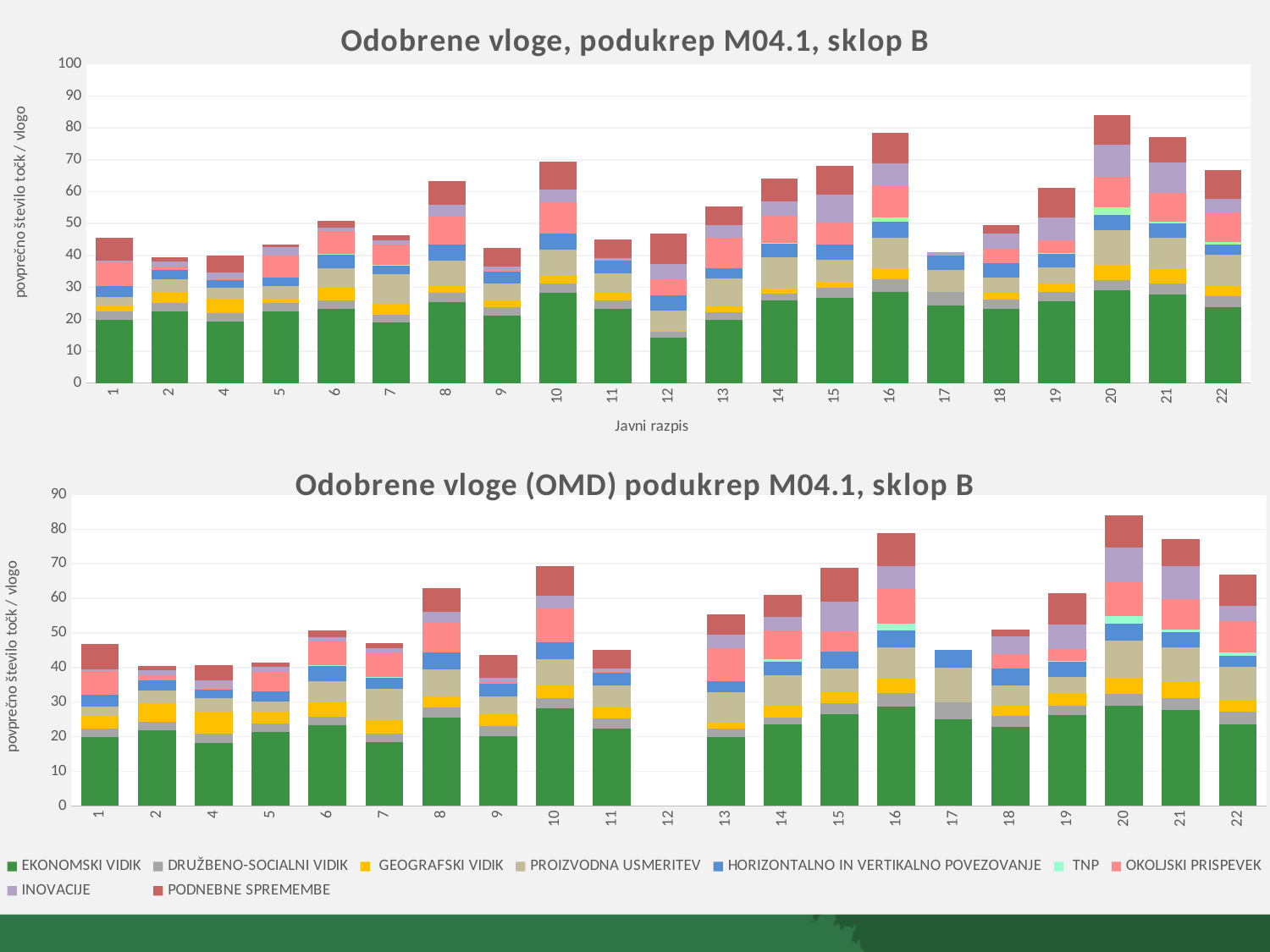
What kind of chart is the top chart, 'Odobrene vloge, podukrep M04.1, sklop B'? Stacked bar chart In the top chart, which category has the tallest stacked bar? 20 In the bottom chart, which has the taller stacked bar, category 10 or category 8? 10 How many series does the legend list? 9 How many categories are shown on the x axis of the top chart? 21 In the bottom chart, 'Odobrene vloge (OMD) podukrep M04.1, sklop B', which category has the tallest stacked bar? 20 In the top chart, is the total for category 10 greater or less than 60? greater In the top chart, is the total for category 20 greater or less than 80? greater In the bottom chart, which category on the x axis has no bar plotted? 12 In the bottom chart, is the total for category 17 greater or less than 50? less In the top chart, which has the taller stacked bar, category 16 or category 15? 16